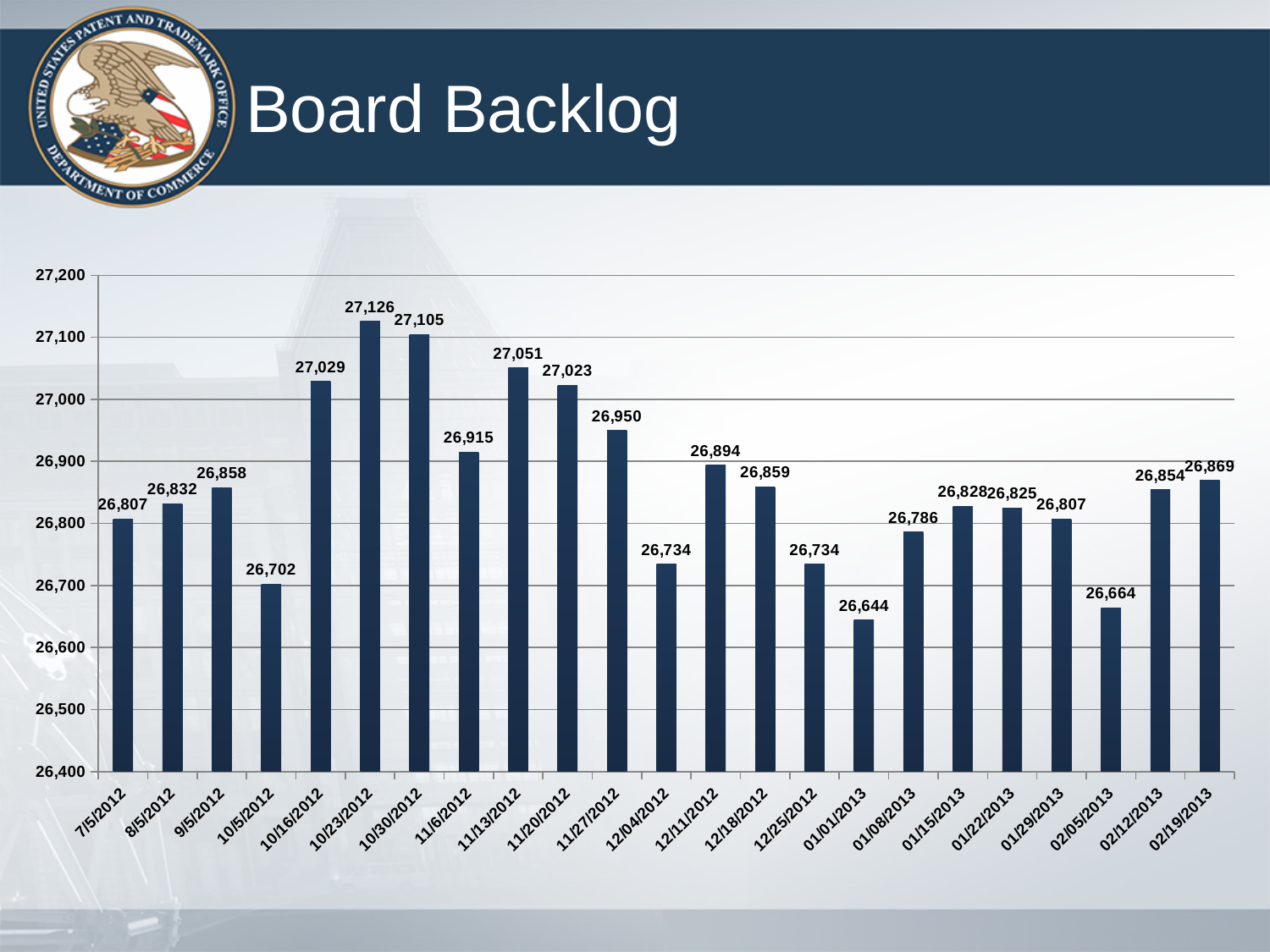
What is the difference between the values for 10/16/2012 and 10/5/2012? 327 Which date has the highest value? 10/23/2012 Which is larger, the value for 11/6/2012 or the value for 11/27/2012? 11/27/2012 How many bars are shown in the chart? 23 What is the value for 01/01/2013? 26,644 What is the difference between the values for 10/23/2012 and 01/01/2013? 482 What is the value for 02/19/2013? 26,869 What kind of chart is shown on the slide? bar chart What is the title of the slide? Board Backlog What is the value for 10/23/2012? 27,126 Which date has the lowest value? 01/01/2013 Is the value for 10/5/2012 greater or less than 26,800? less